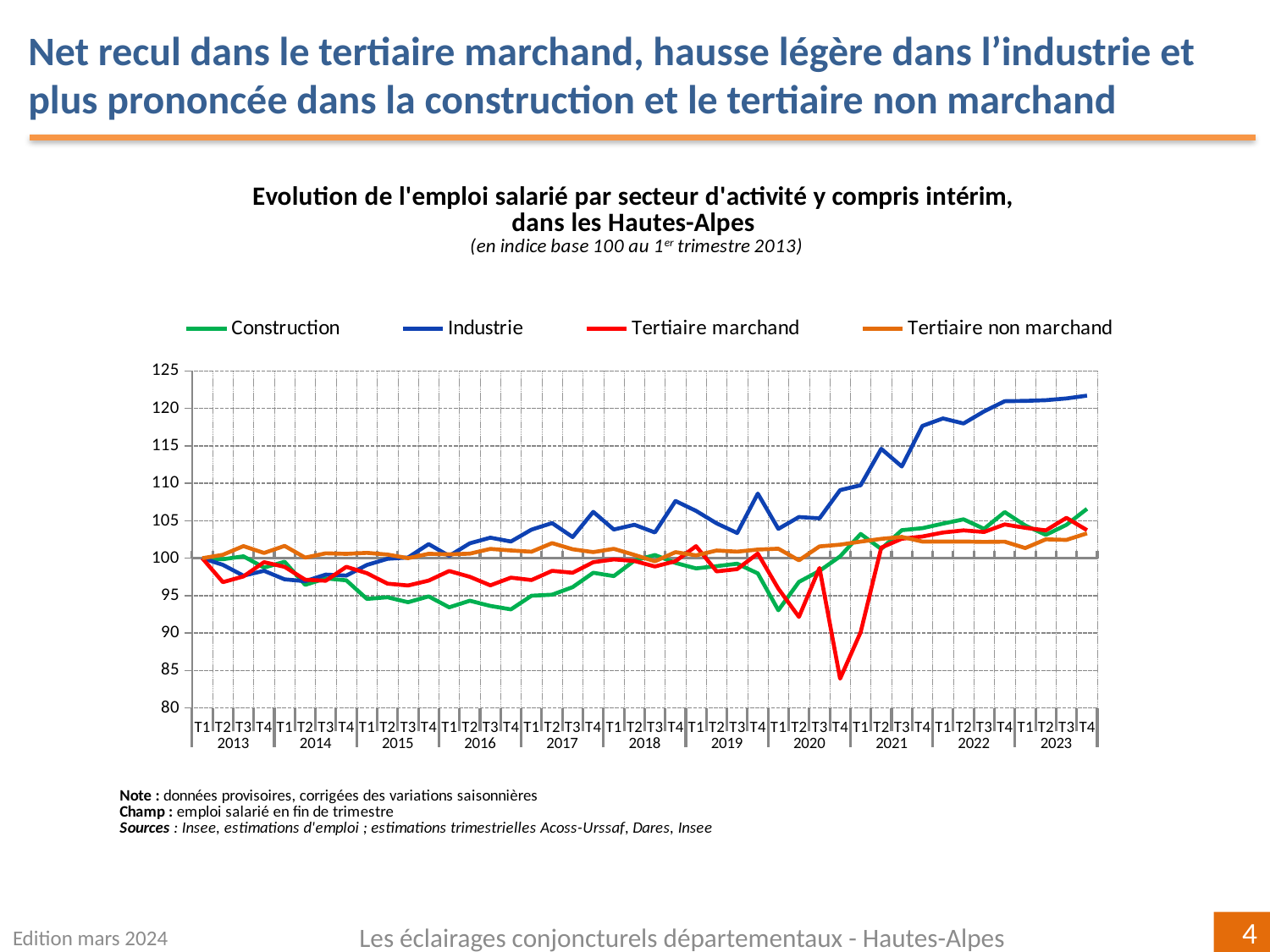
Is the value for Construction at T1 2020 greater or less than 95? less Is the value for Industrie at T2 2021 greater or less than 110? greater What kind of chart is shown on the slide? line chart Which series has the lowest value at T4 2020? Tertiaire marchand Is the value for Tertiaire marchand at T4 2020 greater or less than 90? less What is the index value of every series at T1 2013, the base quarter? 100 Which series has the highest value at T4 2023? Industrie Which series is shown in blue in the legend? Industrie How many series does the legend list? 4 How many years are labelled along the x axis? 11 Does the Industrie series generally rise or fall from 2013 to 2023? rise